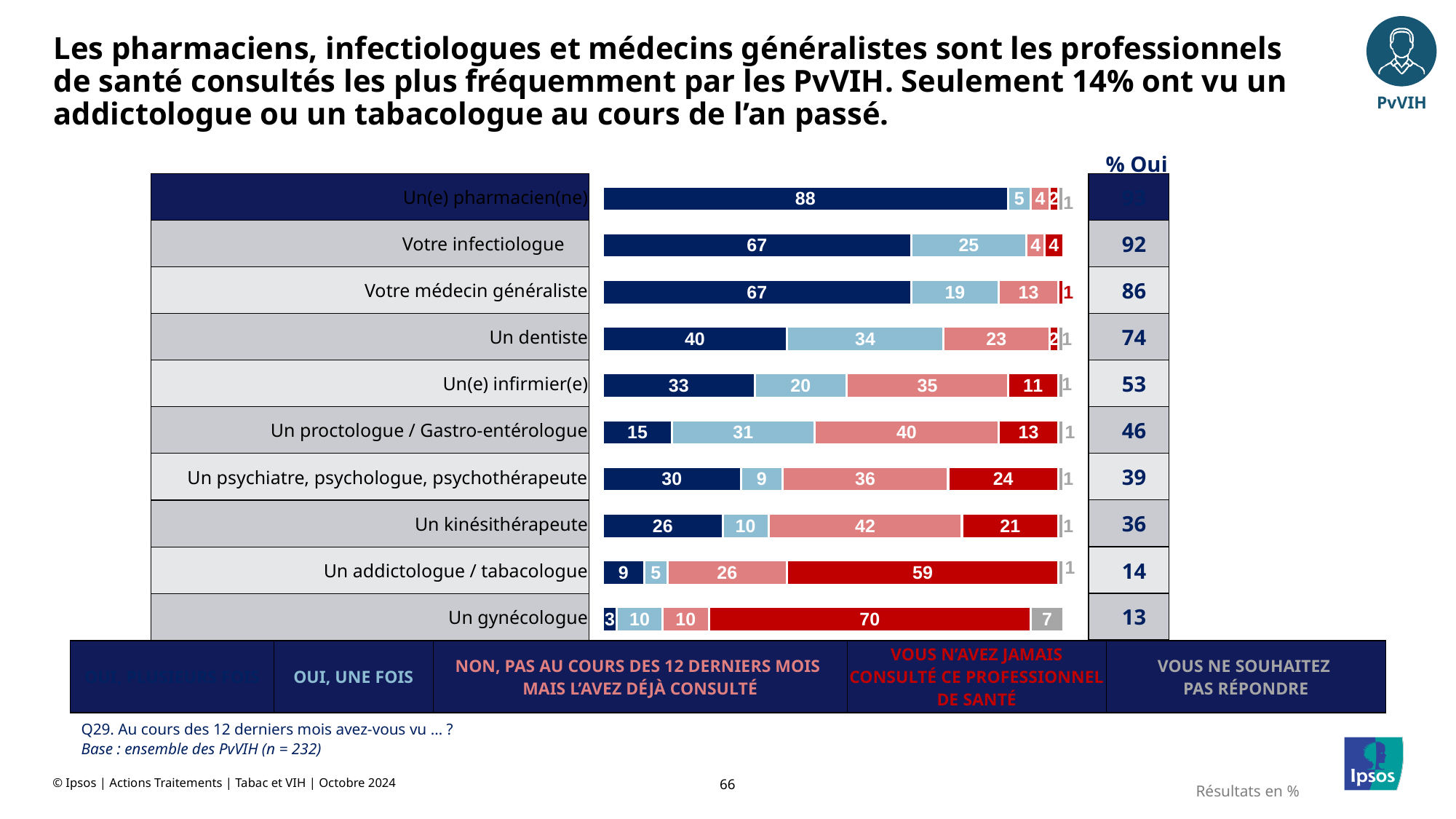
What kind of chart is shown on the slide? Stacked bar chart What is the value of the 'Vous ne souhaitez pas répondre' segment for 'Un gynécologue'? 7 How many categories (health professionals) are shown in the chart? 10 What is the value of the 'Vous n'avez jamais consulté ce professionnel de santé' segment for 'Un gynécologue'? 70 Which category has the highest value for 'Vous n'avez jamais consulté ce professionnel de santé'? Un gynécologue Which category has the lowest '% Oui' value? Un gynécologue How many series does the legend list? 5 Which has a larger 'Oui, une fois' value: 'Un dentiste' or 'Un(e) infirmier(e)'? Un dentiste What is the value of the 'Oui, une fois' segment for 'Votre infectiologue'? 25 What is the value of the 'Non, pas au cours des 12 derniers mois mais l'avez déjà consulté' segment for 'Un kinésithérapeute'? 42 What is the difference between the '% Oui' values for 'Votre infectiologue' and 'Votre médecin généraliste'? 6 What is the '% Oui' value shown for 'Un addictologue / tabacologue'? 14